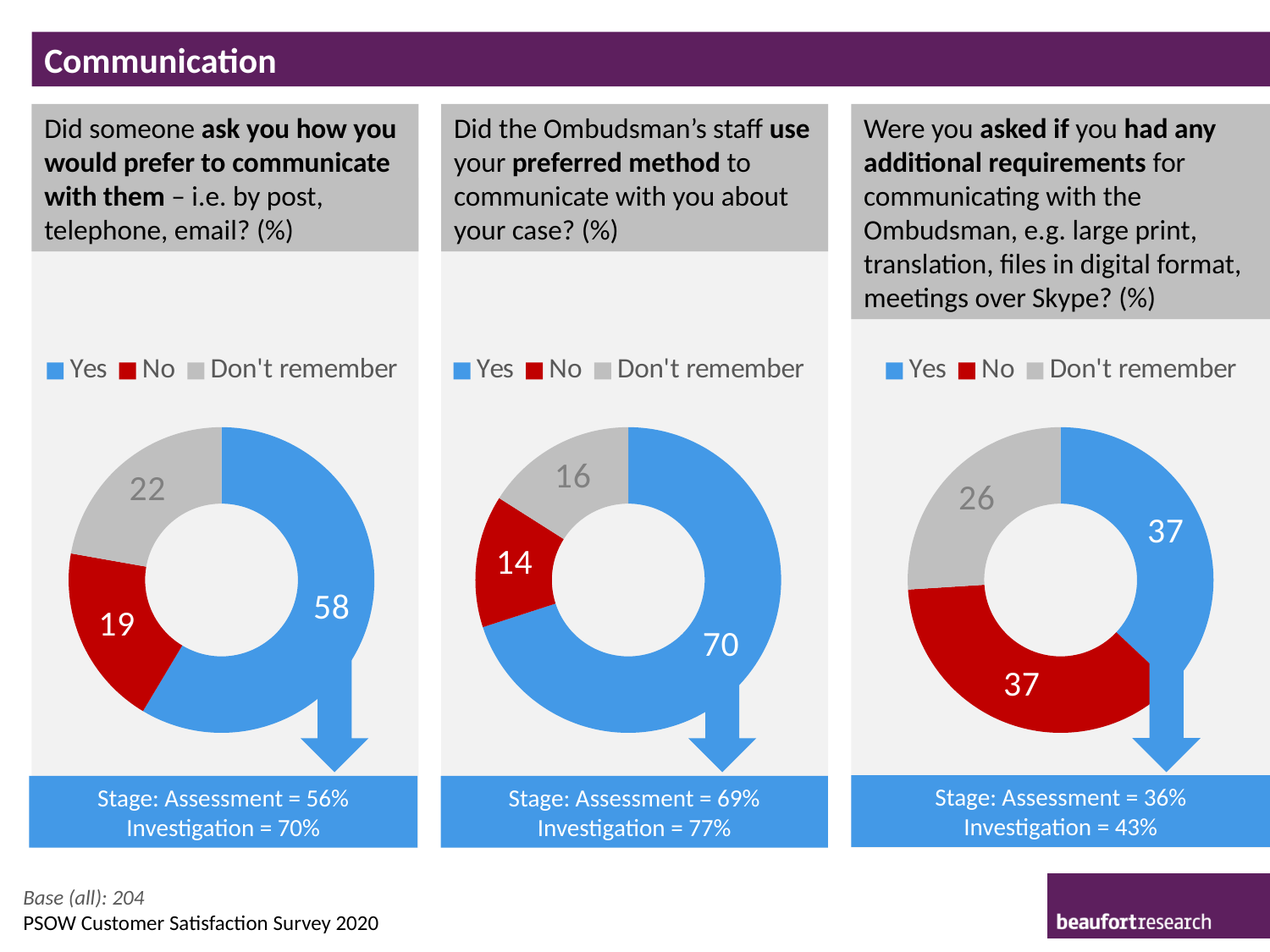
In the right chart (asked if you had any additional requirements), what is the difference between the Yes and Don't remember values? 11 In the left chart (asked how you would prefer to communicate), what is the value for Yes? 58 What kind of chart is the middle chart (staff used your preferred method)? Doughnut chart In the middle chart (staff used your preferred method), which is larger, No or Don't remember? Don't remember In the left chart (asked how you would prefer to communicate), what is the value for Don't remember? 22 In the left chart (asked how you would prefer to communicate), which category has the lowest value? No In the right chart (asked if you had any additional requirements), what is the value for Don't remember? 26 In the right chart (asked if you had any additional requirements), what colour is the Yes segment? Blue In the middle chart (staff used your preferred method), which category has the highest value? Yes How many series does the legend of the left chart list? 3 In the left chart (asked how you would prefer to communicate), what is the difference between the Yes and No values? 39 In the middle chart (staff used your preferred method), what is the value for No? 14